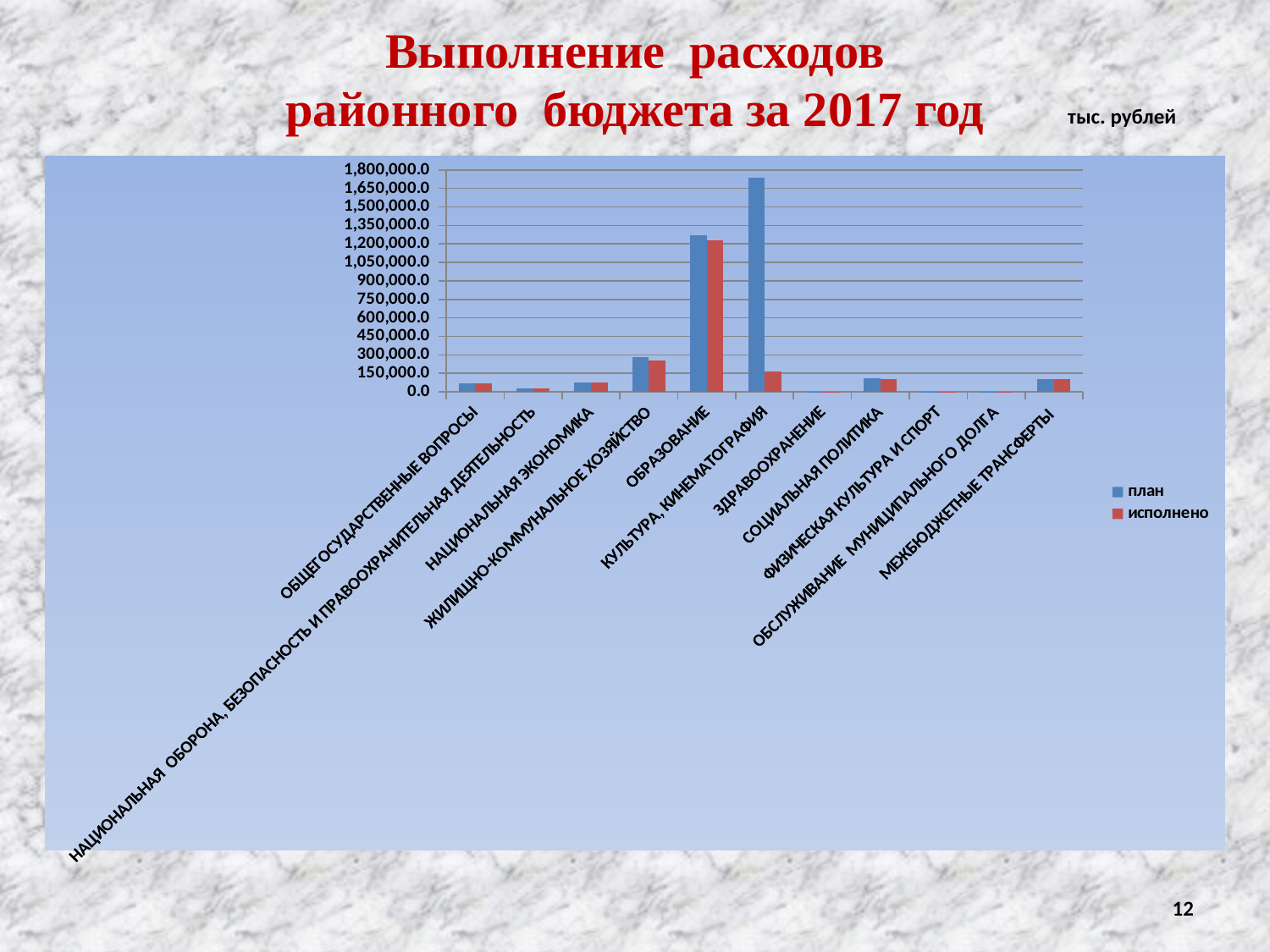
Which is larger: the план value for ОБРАЗОВАНИЕ or the план value for КУЛЬТУРА, КИНЕМАТОГРАФИЯ? КУЛЬТУРА, КИНЕМАТОГРАФИЯ For КУЛЬТУРА, КИНЕМАТОГРАФИЯ, which is larger: the план value or the исполнено value? план Is the план value for КУЛЬТУРА, КИНЕМАТОГРАФИЯ greater or less than 1,500,000.0? greater Is the исполнено value for КУЛЬТУРА, КИНЕМАТОГРАФИЯ greater or less than 300,000.0? less Which category has the highest value for the исполнено series? ОБРАЗОВАНИЕ Which category has the highest value for the план series? КУЛЬТУРА, КИНЕМАТОГРАФИЯ What unit of measurement is indicated for the chart values? тыс. рублей How many categories are shown on the x axis of the chart? 11 Is the план value for ОБРАЗОВАНИЕ greater or less than 1,050,000.0? greater What kind of chart is shown on the slide? bar chart How many series does the legend list? 2